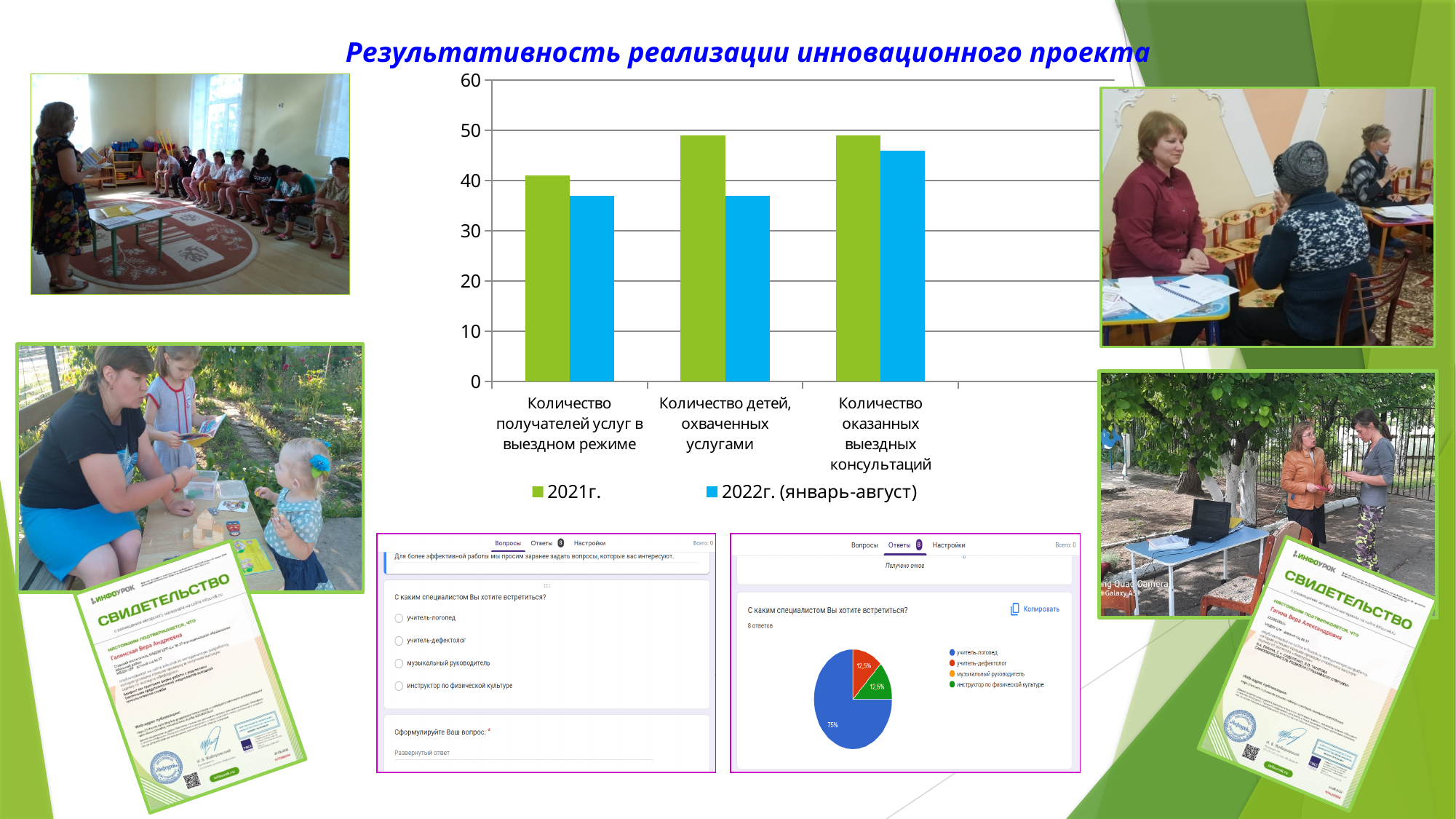
In the central bar chart, what are the two legend entries? 2021г. and 2022г. (январь-август) In the central bar chart, is the 2021г. value for 'Количество получателей услуг в выездном режиме' greater or less than 30? greater How many categories are shown on the x axis of the central bar chart? 3 In the central bar chart, does the 2021г. value rise or fall from 'Количество получателей услуг в выездном режиме' to 'Количество детей, охваченных услугами'? rise In the central bar chart, is the 2021г. value for 'Количество детей, охваченных услугами' greater or less than 40? greater In the central bar chart, is the 2022г. (январь-август) value for 'Количество получателей услуг в выездном режиме' greater or less than 40? less How many series does the legend of the central bar chart list? 2 In the central bar chart, which category has the highest 2022г. (январь-август) value? Количество оказанных выездных консультаций In the central bar chart, for 'Количество получателей услуг в выездном режиме', which series has the larger value, 2021г. or 2022г. (январь-август)? 2021г. In the pie chart in the screenshot at the bottom of the slide, what share does the largest slice (учитель-логопед) have? 75% What kind of chart is the large chart in the centre of the slide? bar chart